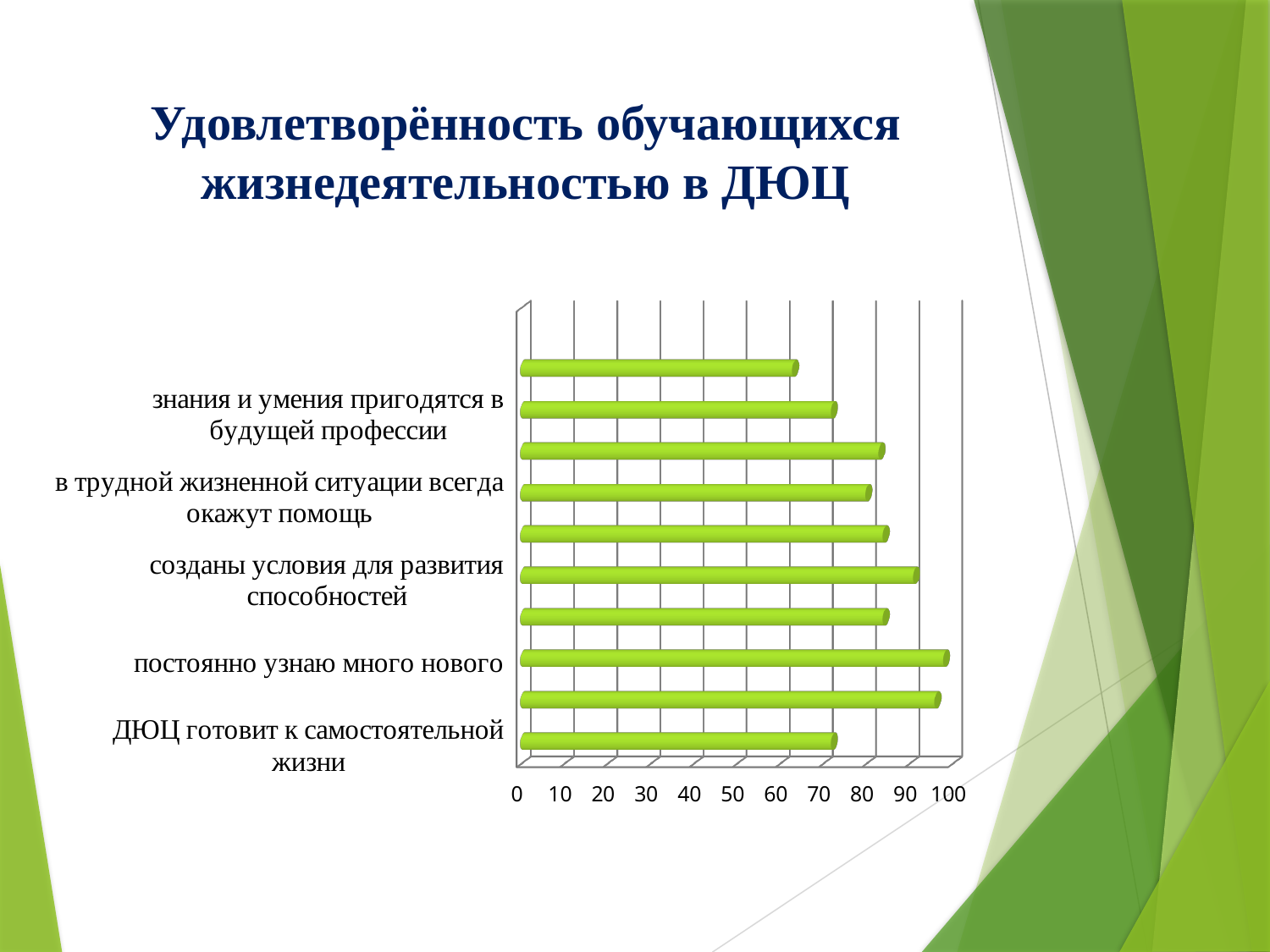
What kind of chart is shown on the slide? bar chart Is the value of the top bar greater or less than 50? greater What is the highest value shown on the horizontal axis? 100 Is the value of the top bar greater or less than 70? less Is the value of the second bar from the bottom greater or less than 90? greater What colour are the bars in the chart? green Which bar in the chart is the shortest? the top bar How many bars are plotted in the chart? 10